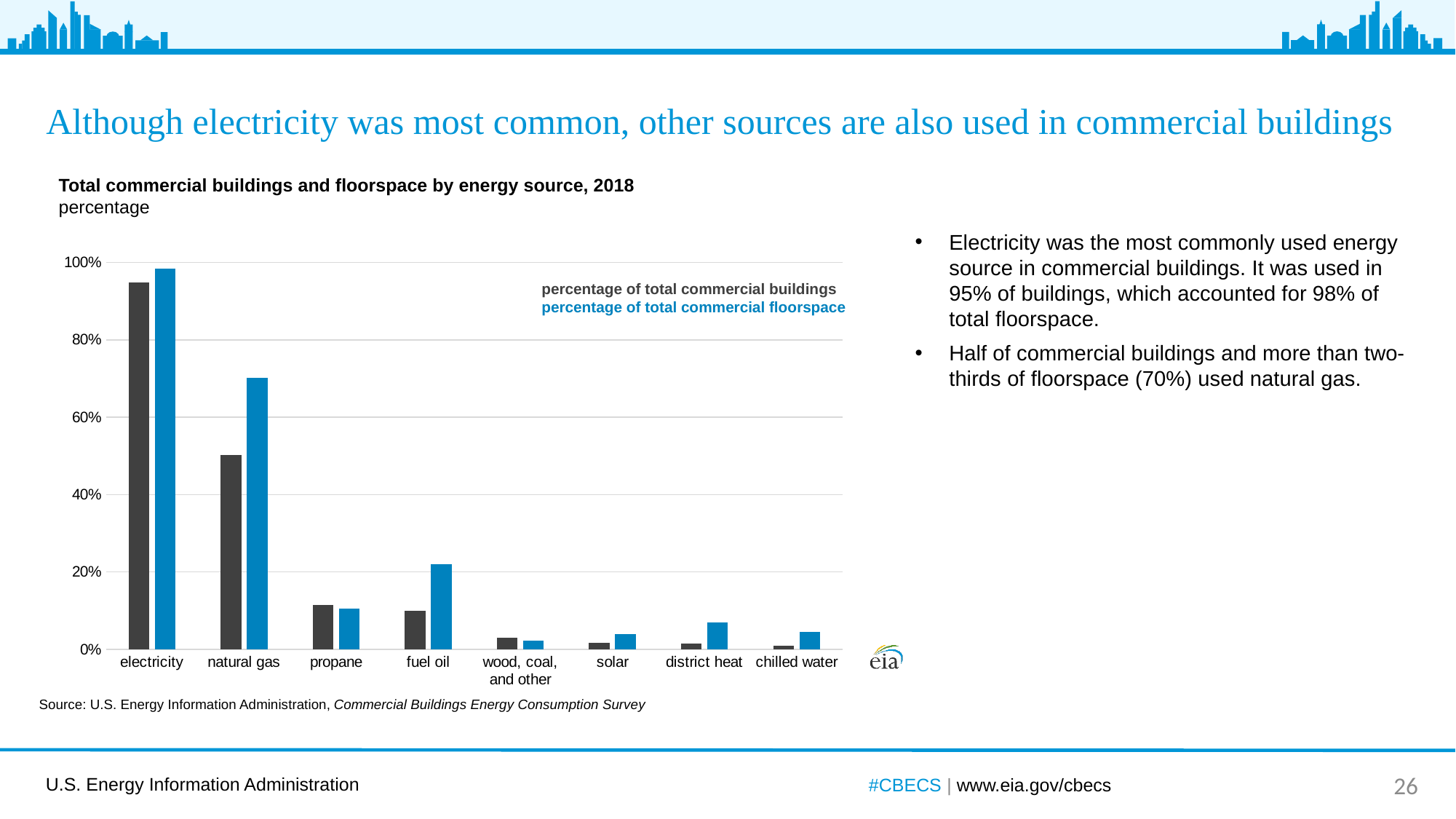
For fuel oil, which is larger: the percentage of total commercial buildings or the percentage of total commercial floorspace? percentage of total commercial floorspace Is the percentage of total commercial buildings for propane greater or less than 20%? less What colour are the bars for percentage of total commercial floorspace? blue Which energy source has the lowest percentage of total commercial floorspace? wood, coal, and other Is the percentage of total commercial floorspace for natural gas greater or less than 60%? greater Which energy source has the highest percentage of total commercial buildings? electricity How many energy source categories are shown on the x axis? 8 Which energy source has the highest percentage of total commercial floorspace? electricity What kind of chart is shown on the slide? bar chart How many series does the chart's legend list? 2 Which has a larger percentage of total commercial floorspace: district heat or solar? district heat Is the percentage of total commercial buildings for electricity greater or less than 80%? greater